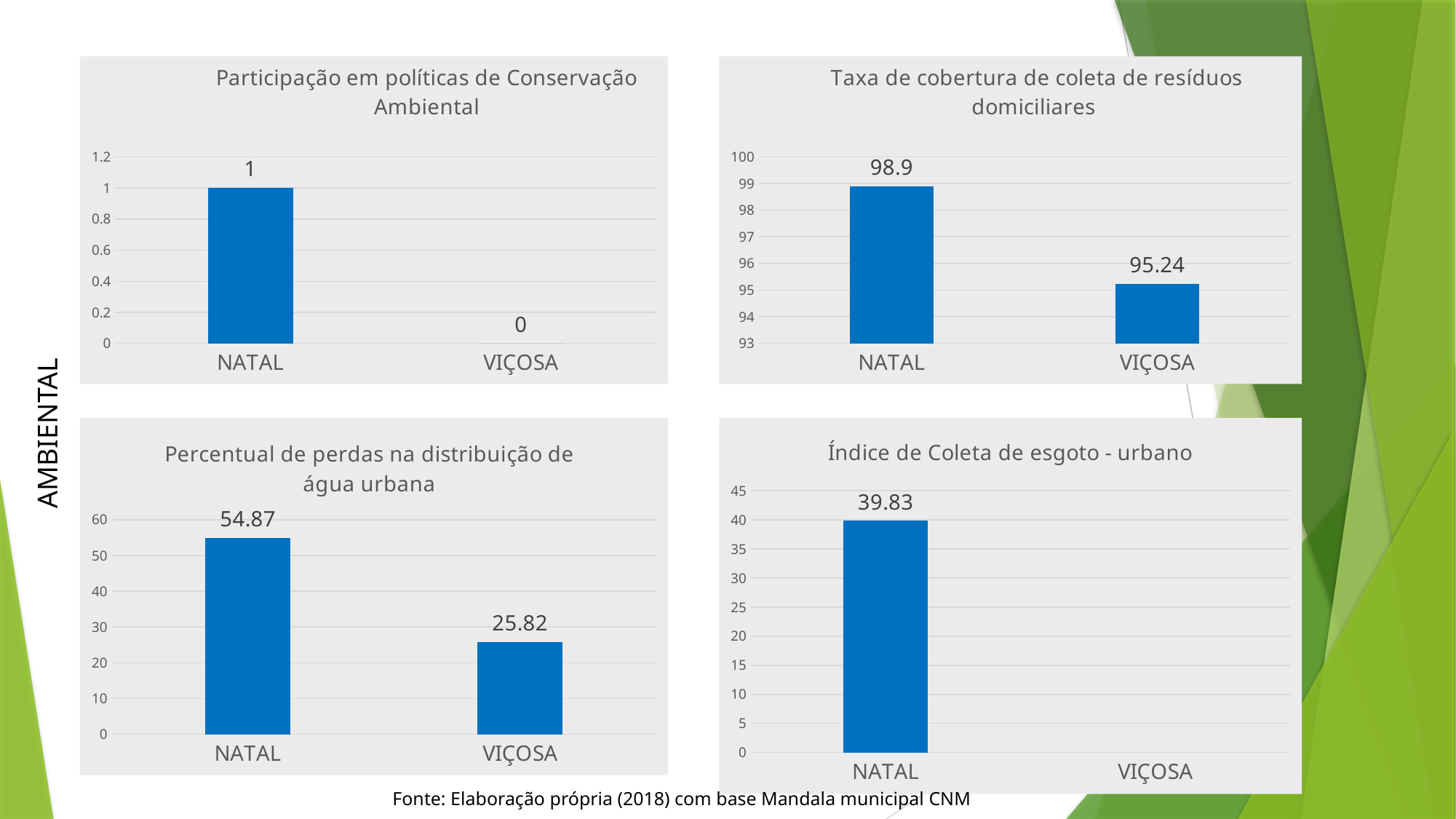
In the chart 'Taxa de cobertura de coleta de resíduos domiciliares', what is the difference between NATAL and VIÇOSA? 3.66 In the chart 'Percentual de perdas na distribuição de água urbana', what is the difference between NATAL and VIÇOSA? 29.05 In the chart 'Percentual de perdas na distribuição de água urbana', what is the value for NATAL? 54.87 In the chart 'Participação em políticas de Conservação Ambiental', what is the value for NATAL? 1 In the chart 'Índice de Coleta de esgoto - urbano', is the value for NATAL greater or less than 35? greater What kind of chart is 'Taxa de cobertura de coleta de resíduos domiciliares'? bar chart In the chart 'Índice de Coleta de esgoto - urbano', what is the value for NATAL? 39.83 In the chart 'Taxa de cobertura de coleta de resíduos domiciliares', what is the value for VIÇOSA? 95.24 In the chart 'Percentual de perdas na distribuição de água urbana', what is the value for VIÇOSA? 25.82 In the chart 'Taxa de cobertura de coleta de resíduos domiciliares', which city has the higher value? NATAL In the chart 'Percentual de perdas na distribuição de água urbana', which city has the lower value? VIÇOSA In the chart 'Participação em políticas de Conservação Ambiental', what is the value for VIÇOSA? 0